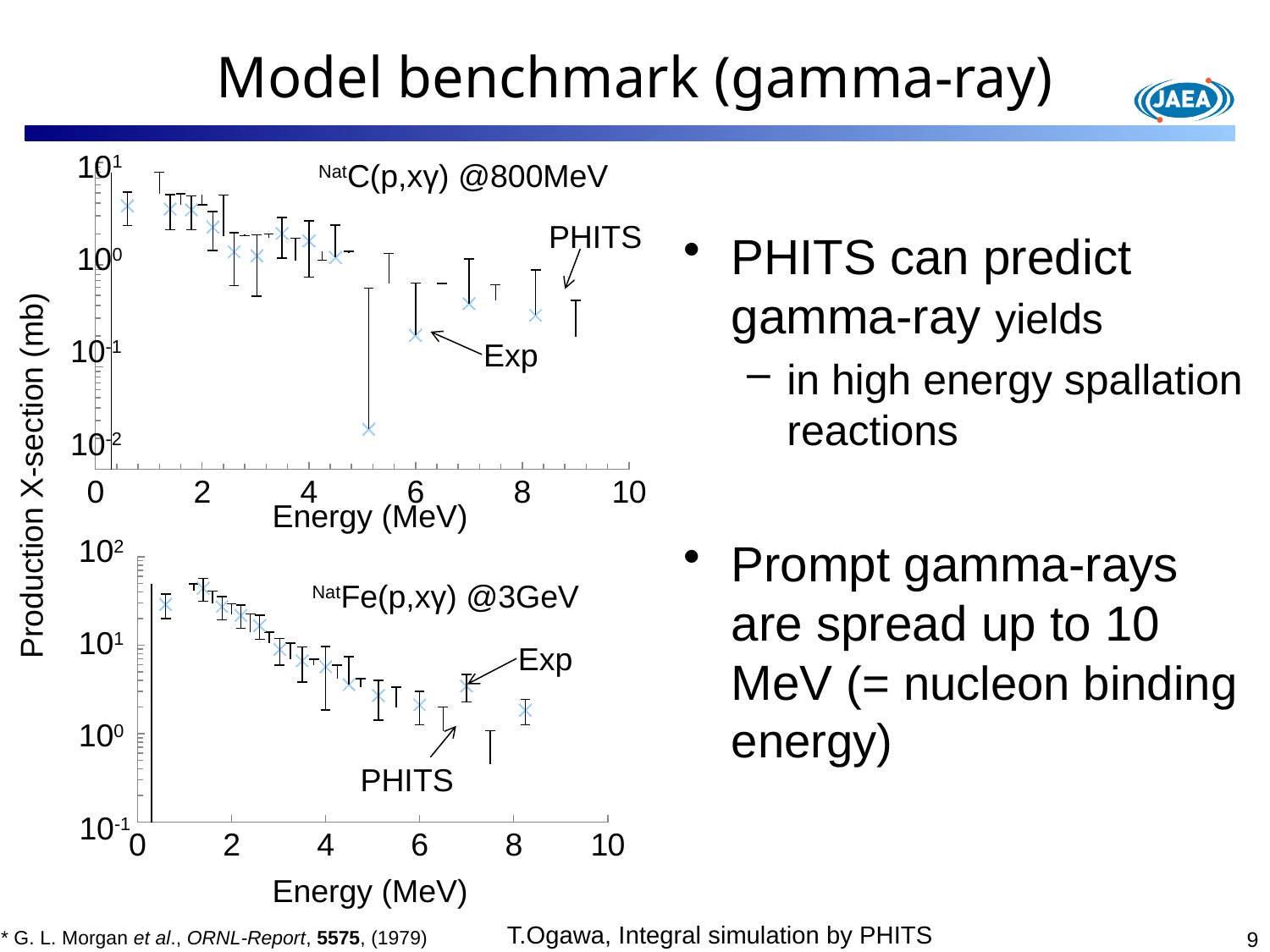
In the bottom chart, NatFe(p,xγ) @3GeV, do the Exp values generally rise or fall as energy increases from 0 to 6 MeV? fall What kind of chart is the top chart, NatC(p,xγ) @800MeV? scatter plot What is the maximum value shown on the x-axis of the top chart, NatC(p,xγ) @800MeV? 10 In the bottom chart, NatFe(p,xγ) @3GeV, what are the names of the two labelled series? PHITS and Exp In the top chart, NatC(p,xγ) @800MeV, is the Exp value near 5 MeV greater or less than 10^-1 mb? less In the top chart, NatC(p,xγ) @800MeV, the lowest Exp point lies between which two labelled energy ticks? 4 and 6 In the top chart, NatC(p,xγ) @800MeV, how many data series are labelled? 2 What is the label of the shared y-axis of the two charts? Production X-section (mb) In the bottom chart, NatFe(p,xγ) @3GeV, is the Exp value at the lowest energy point (near 0.5 MeV) greater or less than 10^1 mb? greater In the bottom chart, NatFe(p,xγ) @3GeV, is the Exp value near 8 MeV greater or less than 10^1 mb? less How many charts are shown on the slide? 2